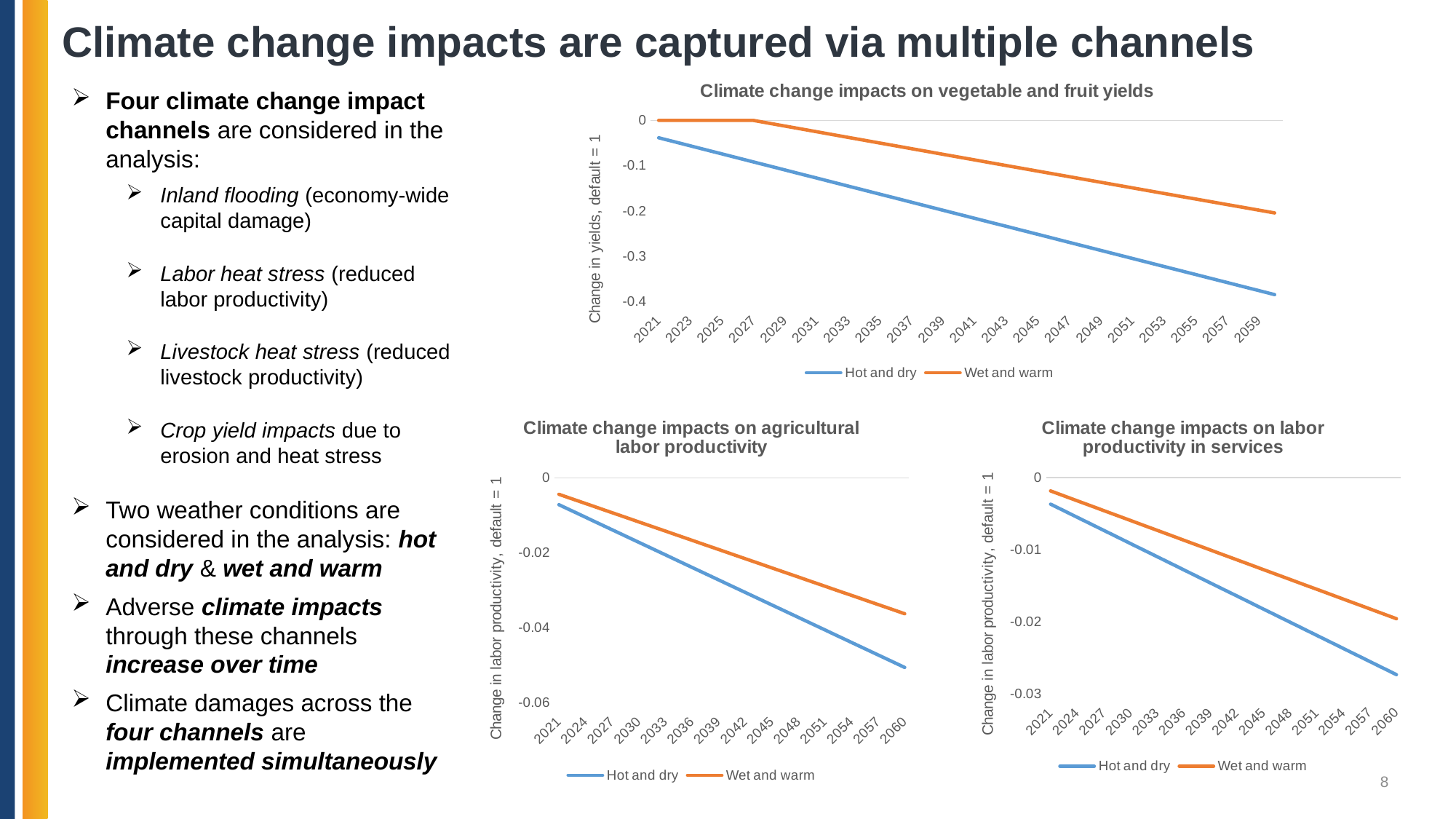
In the 'Climate change impacts on agricultural labor productivity' chart, is the value for 'Wet and warm' in 2060 greater or less than -0.04? greater In the 'Climate change impacts on agricultural labor productivity' chart, is the value for 'Hot and dry' in 2060 greater or less than -0.04? less In the 'Climate change impacts on vegetable and fruit yields' chart, which series has the lower value in 2059, 'Hot and dry' or 'Wet and warm'? Hot and dry In the 'Climate change impacts on labor productivity in services' chart, is the value for 'Hot and dry' in 2060 greater or less than -0.02? less In the 'Climate change impacts on labor productivity in services' chart, which series has the higher value in 2060, 'Hot and dry' or 'Wet and warm'? Wet and warm What are the two series named in the legend of the 'Climate change impacts on vegetable and fruit yields' chart? Hot and dry, Wet and warm What is the y-axis label of the 'Climate change impacts on labor productivity in services' chart? Change in labor productivity, default = 1 What type of chart is 'Climate change impacts on vegetable and fruit yields'? line chart How many series does the legend list in the 'Climate change impacts on vegetable and fruit yields' chart? 2 In the 'Climate change impacts on vegetable and fruit yields' chart, do the values for 'Hot and dry' rise or fall from 2021 to 2059? fall In the 'Climate change impacts on agricultural labor productivity' chart, do the values for 'Wet and warm' rise or fall over time? fall